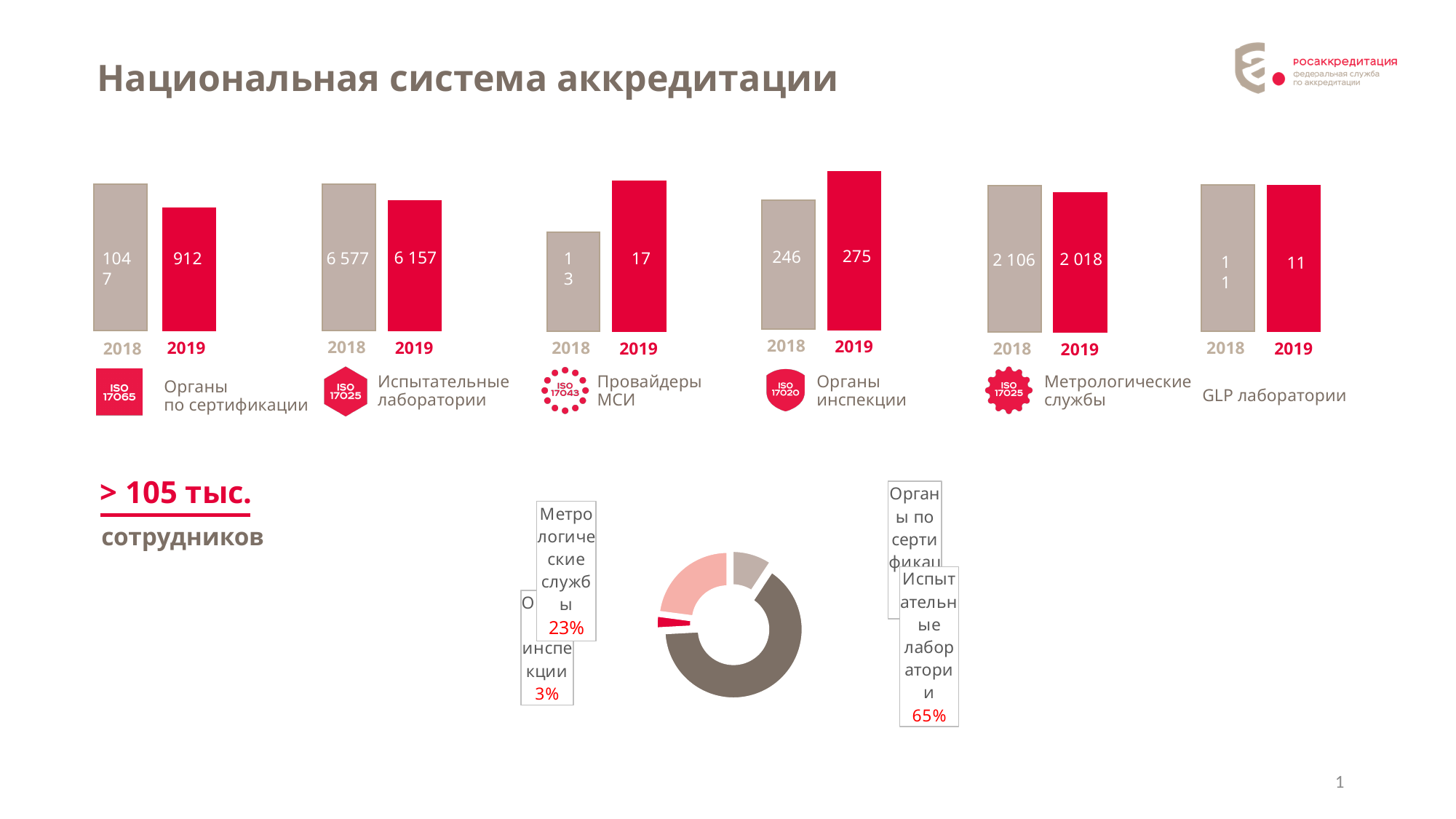
In the donut chart at the bottom of the slide, what share do Метрологические службы have? 23% In the Органы инспекции chart, what is the value for 2019? 275 In the Метрологические службы chart, which year has the larger value, 2018 or 2019? 2018 In the Органы инспекции chart, by how much did the value change from 2018 to 2019? 29 In the Испытательные лаборатории chart, what is the value for 2018? 6 577 In the donut chart at the bottom of the slide, what share do Испытательные лаборатории have? 65% In the Органы по сертификации chart, which year has the larger value, 2018 or 2019? 2018 In the Испытательные лаборатории chart, what is the difference between the 2018 and 2019 values? 420 In the Органы инспекции chart, does the value rise or fall from 2018 to 2019? rise In the Метрологические службы chart, what is the value for 2018? 2 106 In the Провайдеры МСИ chart, what is the value for 2019? 17 In the Испытательные лаборатории chart, what is the value for 2019? 6 157